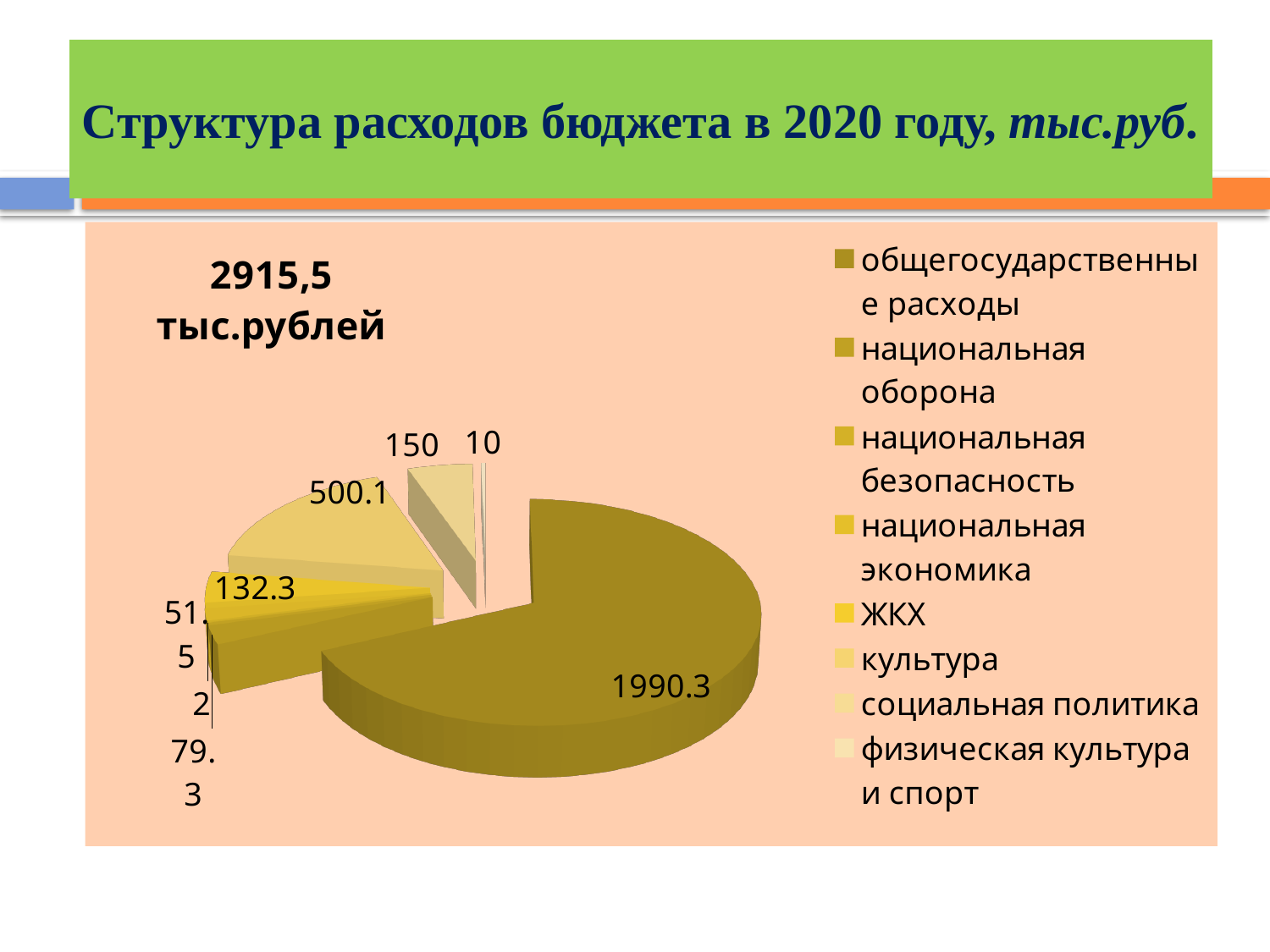
What is the difference between the values for культура and социальная политика? 350.1 What is the title of the slide? Структура расходов бюджета в 2020 году, тыс.руб. Which category has the largest slice in the pie chart? общегосударственные расходы What value is shown for социальная политика? 150 What total amount is stated on the slide for the budget expenditures? 2915,5 тыс.рублей How many categories does the legend of the pie chart list? 8 What kind of chart is shown on the slide? pie chart Which is larger, the value for культура or the value for социальная политика? культура What value is shown for культура? 500.1 What value is shown for ЖКХ? 132.3 What is the value of the largest slice (общегосударственные расходы)? 1990.3